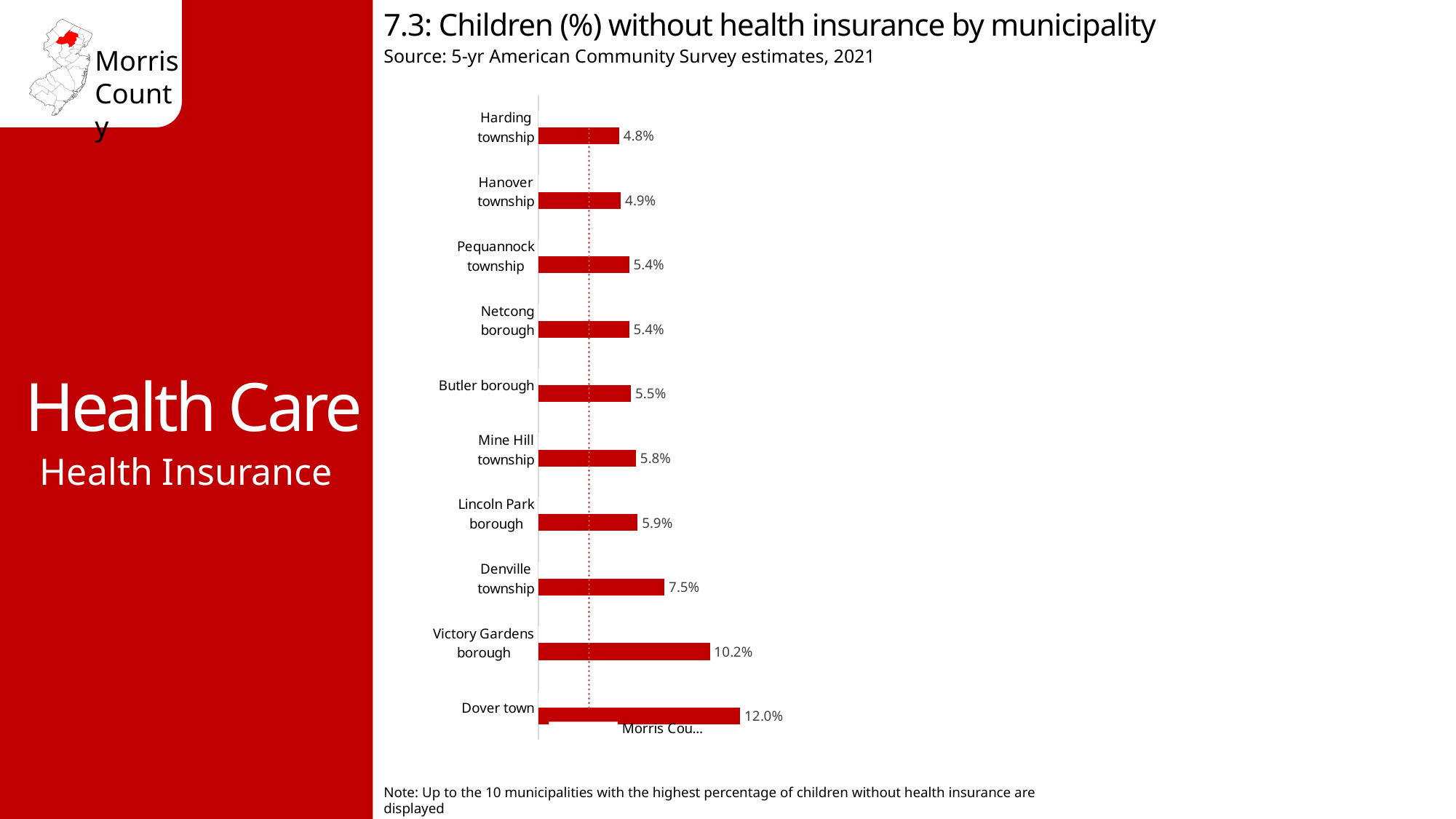
What is the difference between the values for Dover town and Victory Gardens borough? 1.8% What kind of chart is shown on the slide? Bar chart What is the title of the chart? 7.3: Children (%) without health insurance by municipality What is the value shown for Victory Gardens borough? 10.2% What is the value shown for Denville township? 7.5% Which municipality has the lowest percentage of children without health insurance among those displayed? Harding township What is the percentage of children without health insurance in Dover town? 12.0% How many municipalities are shown in the chart? 10 Do the values increase or decrease going from the top of the chart to the bottom? Increase What is the value shown for Harding township? 4.8% Which has a higher value, Denville township or Lincoln Park borough? Denville township Which municipality has the highest percentage of children without health insurance? Dover town